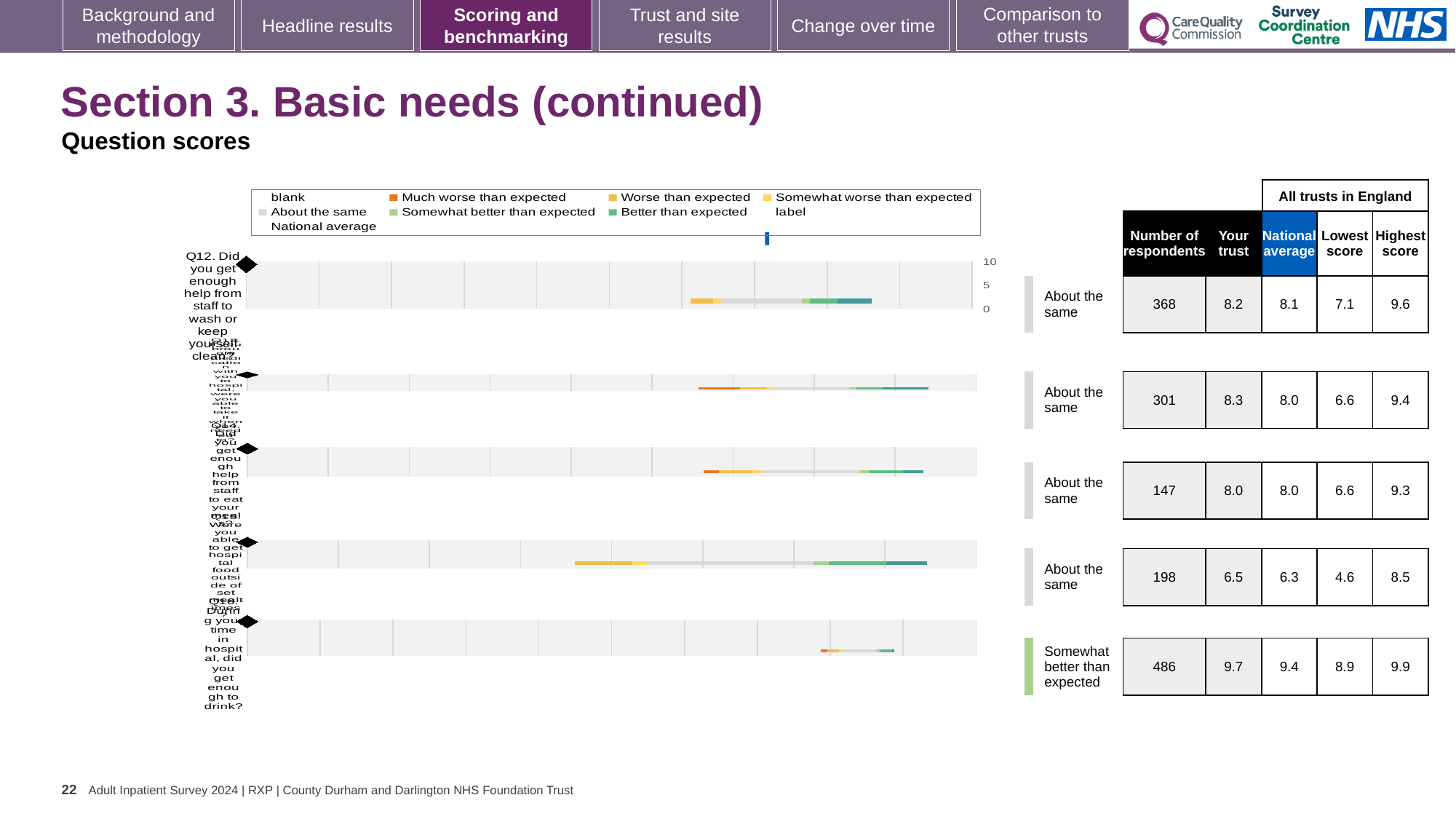
Which colour in the legend represents 'Better than expected'? green Which colour in the legend represents 'Much worse than expected'? orange What kind of chart is used to show the question scores on this slide? bar chart For Q12, what is the difference between the highest score (9.6) and the lowest score (7.1) across all trusts in England? 2.5 What is the 'Your trust' score for Q12 (help from staff to wash or keep yourself clean)? 8.2 Which row has the highest 'Your trust' score? the fifth (bottom) row, 9.7 How many respondents are shown for Q12 (Did you get enough help from staff to wash or keep yourself clean?)? 368 What benchmark category is given for the fifth (bottom) row of the chart? Somewhat better than expected For Q12, is the 'Your trust' score or the national average score larger? Your trust What is the national average score for Q12 (help from staff to wash or keep yourself clean)? 8.1 How many question rows are plotted in the chart? 5 Which row has the lowest 'Your trust' score? the fourth row, 6.5